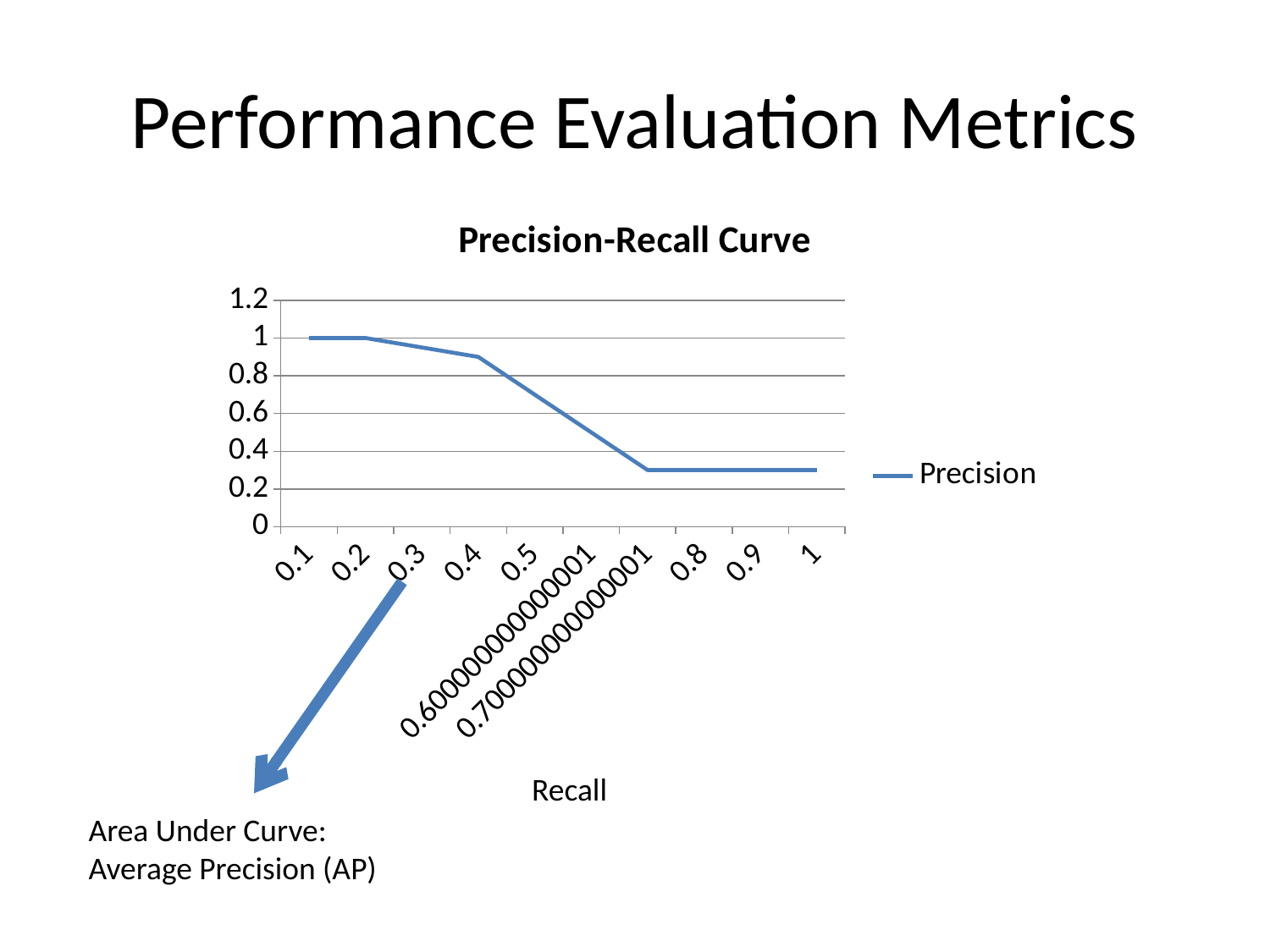
Does the Precision value rise or fall as recall increases along the x axis? fall What is the Precision value at recall 0.2? 1 Is the Precision value at recall 0.5 greater or less than 0.4? greater What series does the legend list? Precision Which has the higher Precision value: recall 0.4 or recall 0.8? recall 0.4 Is the Precision value at recall 0.4 greater or less than 0.8? greater What is the title of the chart? Precision-Recall Curve What kind of chart is shown on the slide? line chart What is the Precision value at recall 0.1? 1 How many series does the legend list? 1 How many data points are plotted on the Precision line? 10 Is the Precision value at recall 0.8 greater or less than 0.4? less